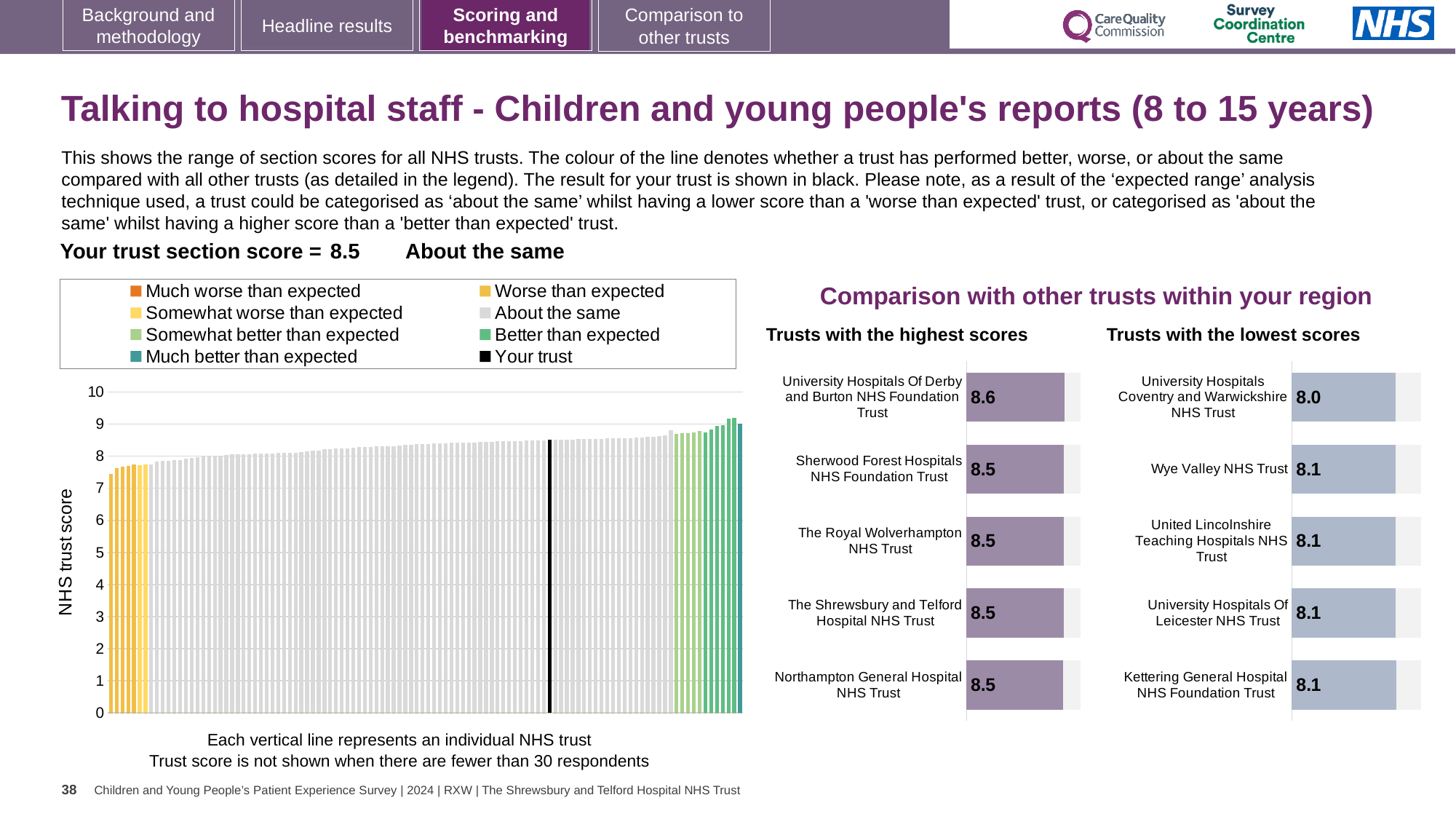
Which is larger: the score for University Hospitals Of Derby and Burton NHS Foundation Trust in the 'Trusts with the highest scores' chart, or the score for Kettering General Hospital NHS Foundation Trust in the 'Trusts with the lowest scores' chart? University Hospitals Of Derby and Burton NHS Foundation Trust In the 'Trusts with the lowest scores' chart, which trust has the lowest score? University Hospitals Coventry and Warwickshire NHS Trust How many trusts are shown in the 'Trusts with the highest scores' chart? 5 How many entries does the legend above the large chart on the left list? 8 In the 'Trusts with the lowest scores' chart, what is the score for University Hospitals Coventry and Warwickshire NHS Trust? 8.0 In the large chart on the left, is the value for the black 'Your trust' bar greater or less than 8? greater What kind of chart is the large chart on the left of the slide? bar chart In the 'Trusts with the lowest scores' chart, what is the difference between the score for Wye Valley NHS Trust and the score for University Hospitals Coventry and Warwickshire NHS Trust? 0.1 In the 'Trusts with the highest scores' chart, what is the difference between the score for University Hospitals Of Derby and Burton NHS Foundation Trust and the score for Sherwood Forest Hospitals NHS Foundation Trust? 0.1 In the 'Trusts with the highest scores' chart, which trust has the highest score? University Hospitals Of Derby and Burton NHS Foundation Trust In the large chart on the left, are the values for the yellow bars at the far left greater or less than 7? greater In the 'Trusts with the highest scores' chart, what is the score for University Hospitals Of Derby and Burton NHS Foundation Trust? 8.6